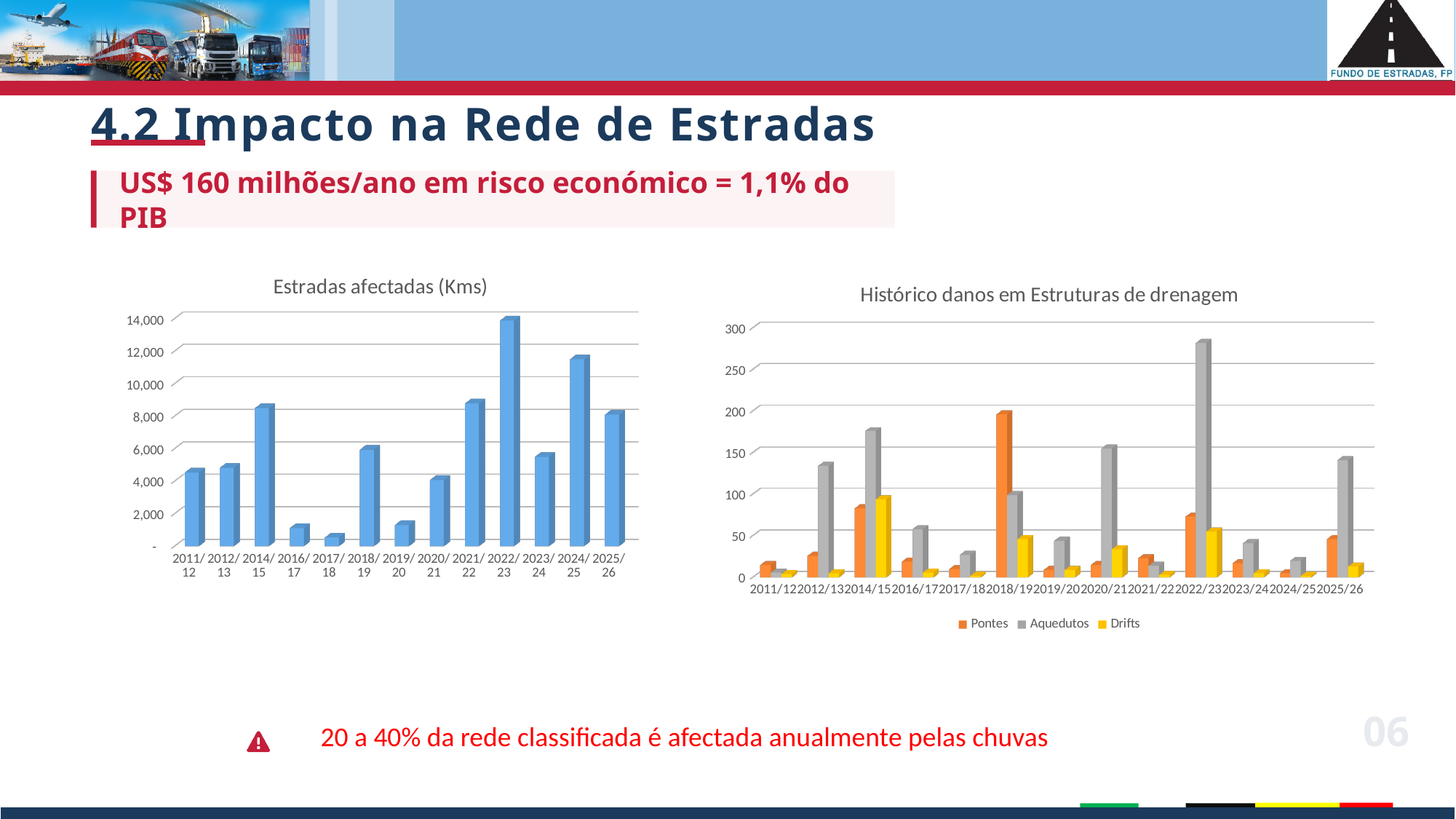
In the 'Histórico danos em Estruturas de drenagem' chart, in which year is the Pontes value highest? 2018/19 What kind of chart is the 'Estradas afectadas (Kms)' chart? bar chart In the 'Estradas afectadas (Kms)' chart, which is larger, the value for 2014/15 or the value for 2020/21? 2014/15 In the 'Estradas afectadas (Kms)' chart, which year has the lowest value? 2017/18 In the 'Estradas afectadas (Kms)' chart, how many year categories are shown on the x axis? 13 In the 'Estradas afectadas (Kms)' chart, is the value for 2016/17 greater or less than 2,000? less In the 'Estradas afectadas (Kms)' chart, which year has the highest value? 2022/23 In the 'Histórico danos em Estruturas de drenagem' chart, which series is shown in yellow? Drifts How many series does the legend of the 'Histórico danos em Estruturas de drenagem' chart list? 3 In the 'Histórico danos em Estruturas de drenagem' chart, is the Aquedutos value for 2022/23 greater or less than 250? greater In the 'Histórico danos em Estruturas de drenagem' chart, in which year is the Aquedutos value highest? 2022/23 In the 'Estradas afectadas (Kms)' chart, is the value for 2022/23 greater or less than 12,000? greater